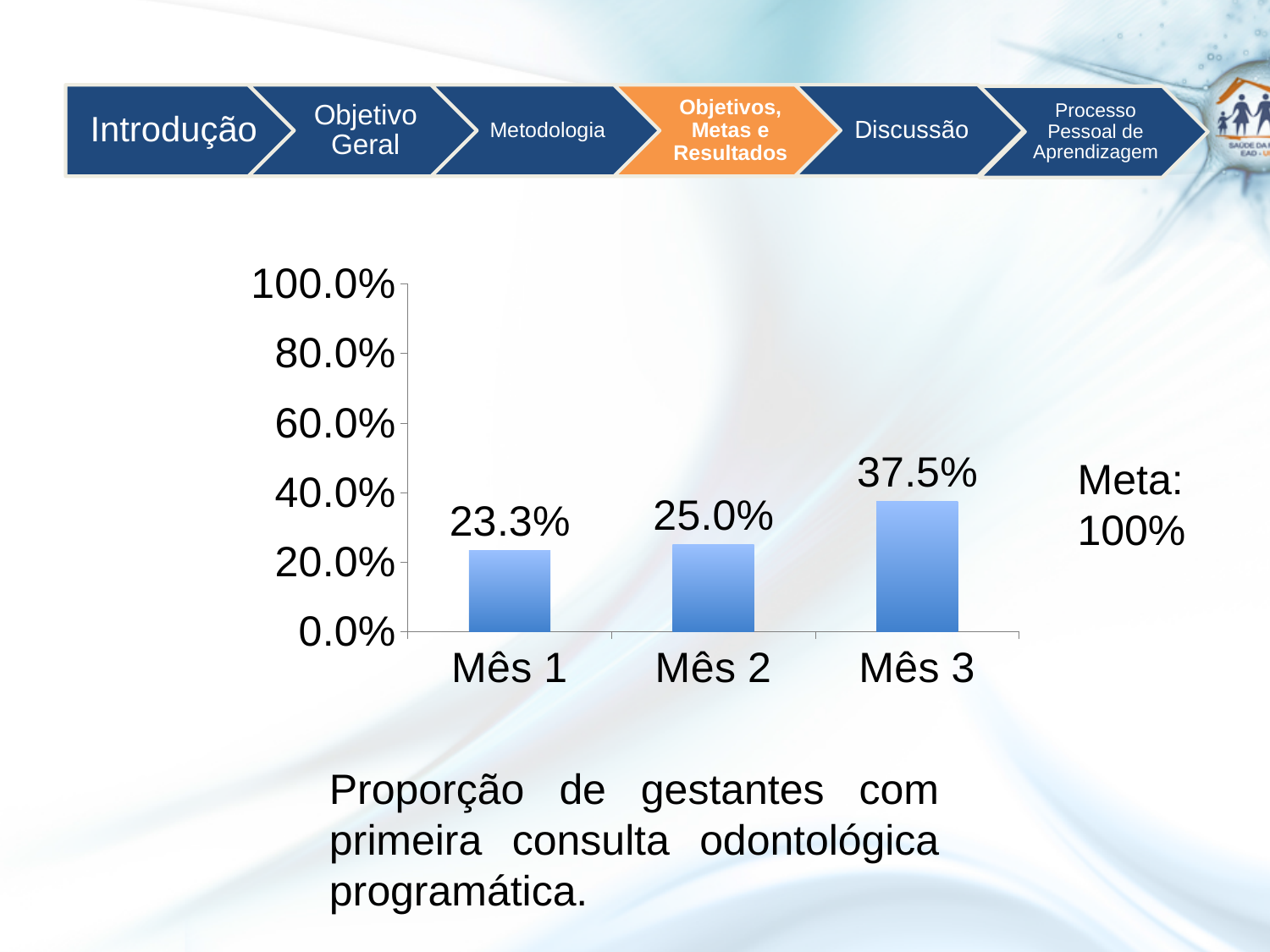
What is the value for Mês 2? 25.0% How many months are shown on the x axis? 3 What is the value for Mês 1? 23.3% Is the value for Mês 3 greater or less than 40.0%? less Do the values rise or fall from Mês 1 to Mês 3? rise Which month has the highest value? Mês 3 Which month has the lowest value? Mês 1 What is the difference between the values for Mês 2 and Mês 1? 1.7% What kind of chart is shown on the slide? bar chart Which is larger, the value for Mês 3 or the value for Mês 2? Mês 3 What is the value for Mês 3? 37.5% What is the difference between the values for Mês 3 and Mês 1? 14.2%